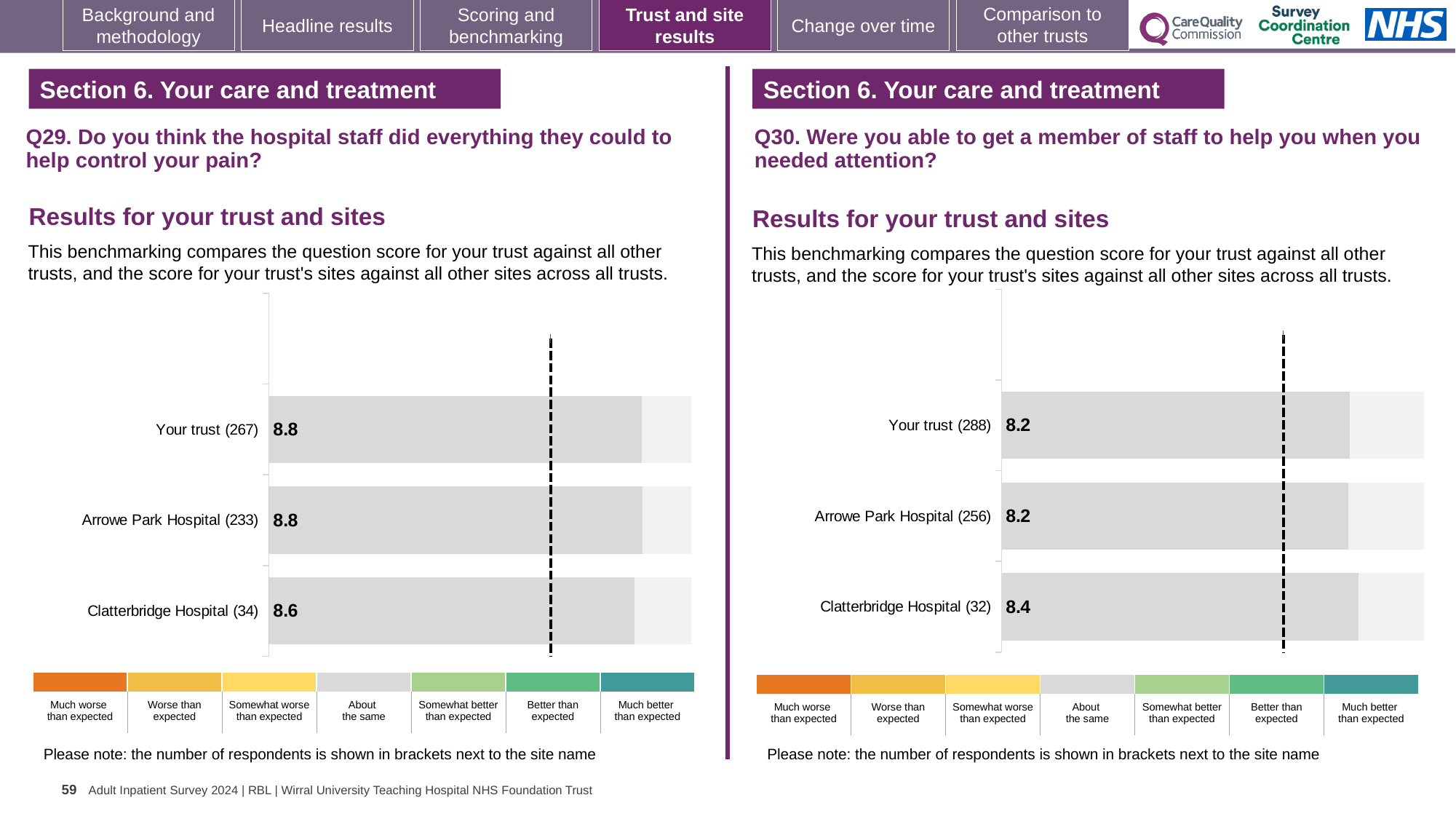
On the Q29 chart (left), which site or trust has the lowest score? Clatterbridge Hospital On the Q29 chart (left), what is the difference between the score for Arrowe Park Hospital and the score for Clatterbridge Hospital? 0.2 On the Q30 chart (right), what is the score for Arrowe Park Hospital? 8.2 On the Q30 chart (right), which site or trust has the highest score? Clatterbridge Hospital On the Q30 chart (right), what is the difference between the score for Clatterbridge Hospital and the score for Your trust? 0.2 What kind of chart is the Q30 chart (right)? Bar chart How many bars are plotted on the Q29 chart (left)? 3 On the Q29 chart (left), what is the score for Clatterbridge Hospital? 8.6 On the Q30 chart (right), which has the larger score, Your trust or Clatterbridge Hospital? Clatterbridge Hospital On the Q29 chart (left), what is the score for Your trust? 8.8 On the Q29 chart (left), how many respondents are shown in brackets for Arrowe Park Hospital? 233 On the Q30 chart (right), what is the score for Clatterbridge Hospital? 8.4